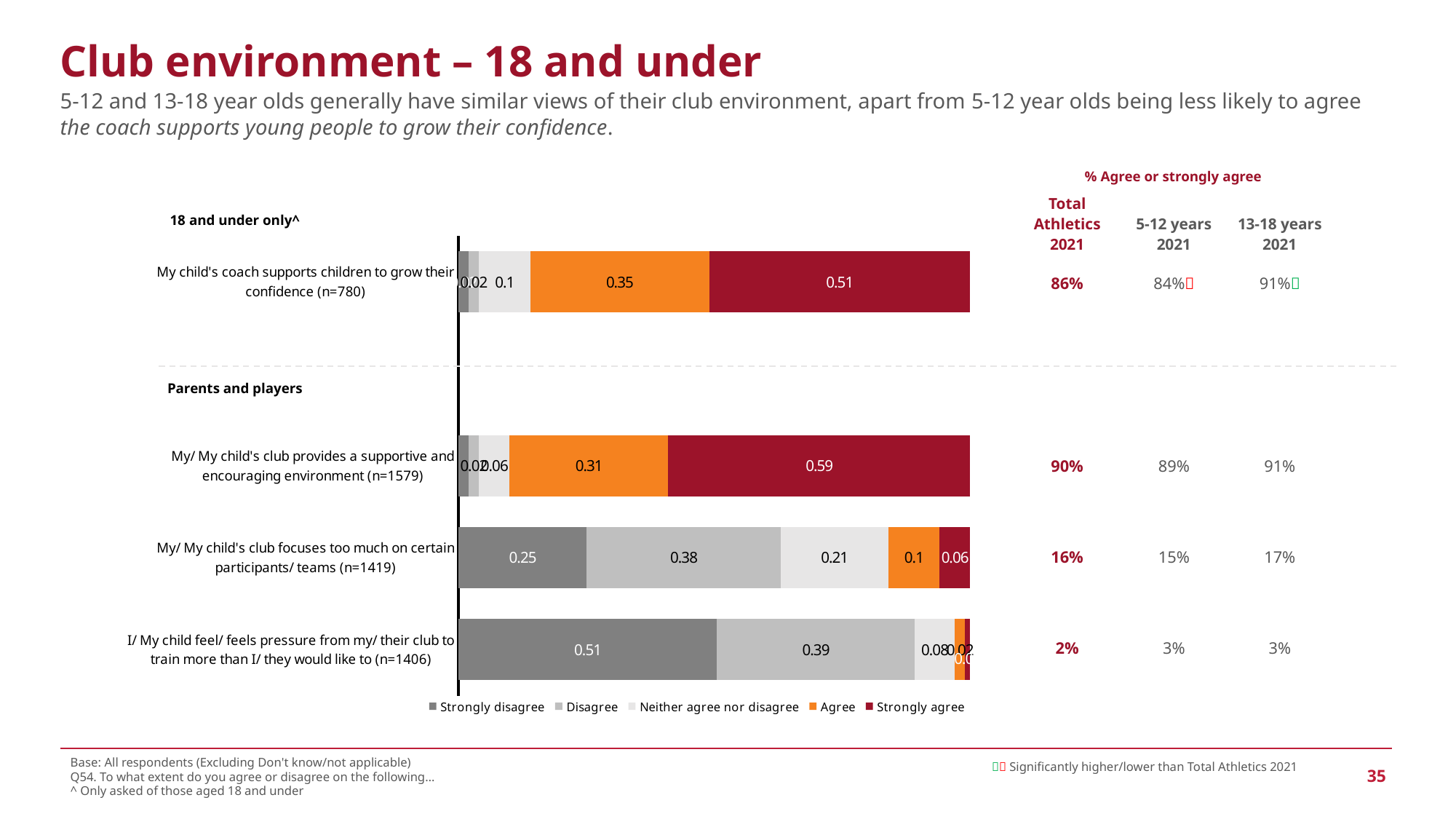
What is the Agree value for 'My child's coach supports children to grow their confidence'? 0.35 What kind of chart is shown on the slide? Stacked bar chart What is the Neither agree nor disagree value for 'My/ My child's club focuses too much on certain participants/ teams'? 0.21 What colour represents Strongly agree in the chart? Dark red What is the Strongly disagree value for 'I/ My child feel/ feels pressure from my/ their club to train more than I/ they would like to'? 0.51 What is the Strongly agree value for 'My/ My child's club provides a supportive and encouraging environment'? 0.59 What is the difference between the Strongly agree values for 'club provides a supportive and encouraging environment' and 'coach supports children to grow their confidence'? 0.08 Which statement has the highest Strongly agree value? My/ My child's club provides a supportive and encouraging environment How many series does the legend list? 5 Which has the larger Strongly disagree value: 'feels pressure from my/ their club to train more' or 'club focuses too much on certain participants/ teams'? Feels pressure from my/ their club to train more What is the Disagree value for 'My/ My child's club focuses too much on certain participants/ teams'? 0.38 How many statements (categories) are plotted in the chart? 4